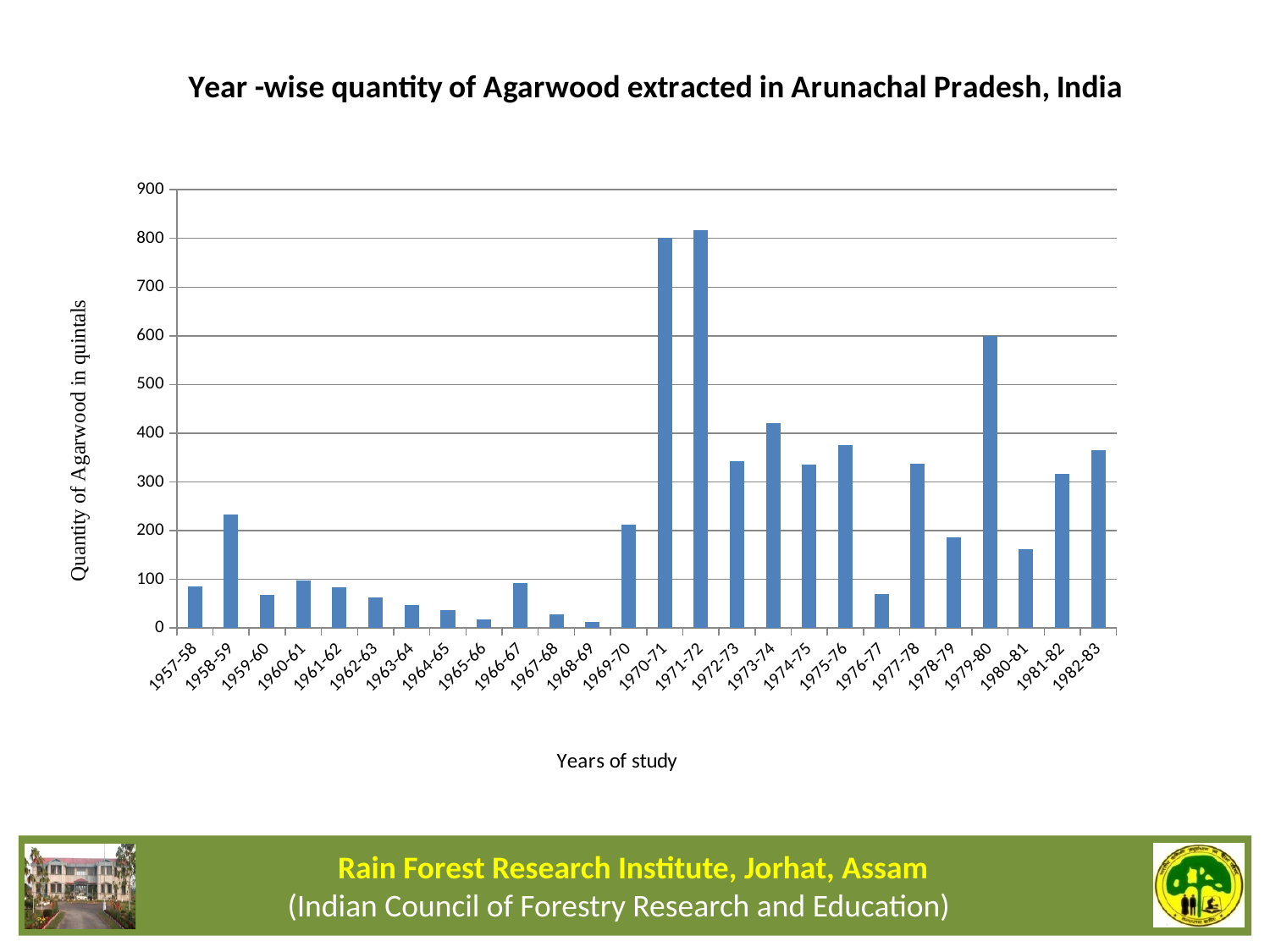
What kind of chart is shown on the slide? bar chart Which is larger, the value for 1976-77 or the value for 1977-78? 1977-78 Is the value for 1970-71 greater or less than 700? greater How many years of study are plotted on the x axis? 26 Which is larger, the value for 1973-74 or the value for 1972-73? 1973-74 Which year has the highest quantity of Agarwood extracted? 1971-72 What is the label of the y axis? Quantity of Agarwood in quintals Is the value for 1973-74 greater or less than 400? greater Is the value for 1979-80 greater or less than 500? greater Do the values rise or fall from 1962-63 to 1965-66? fall